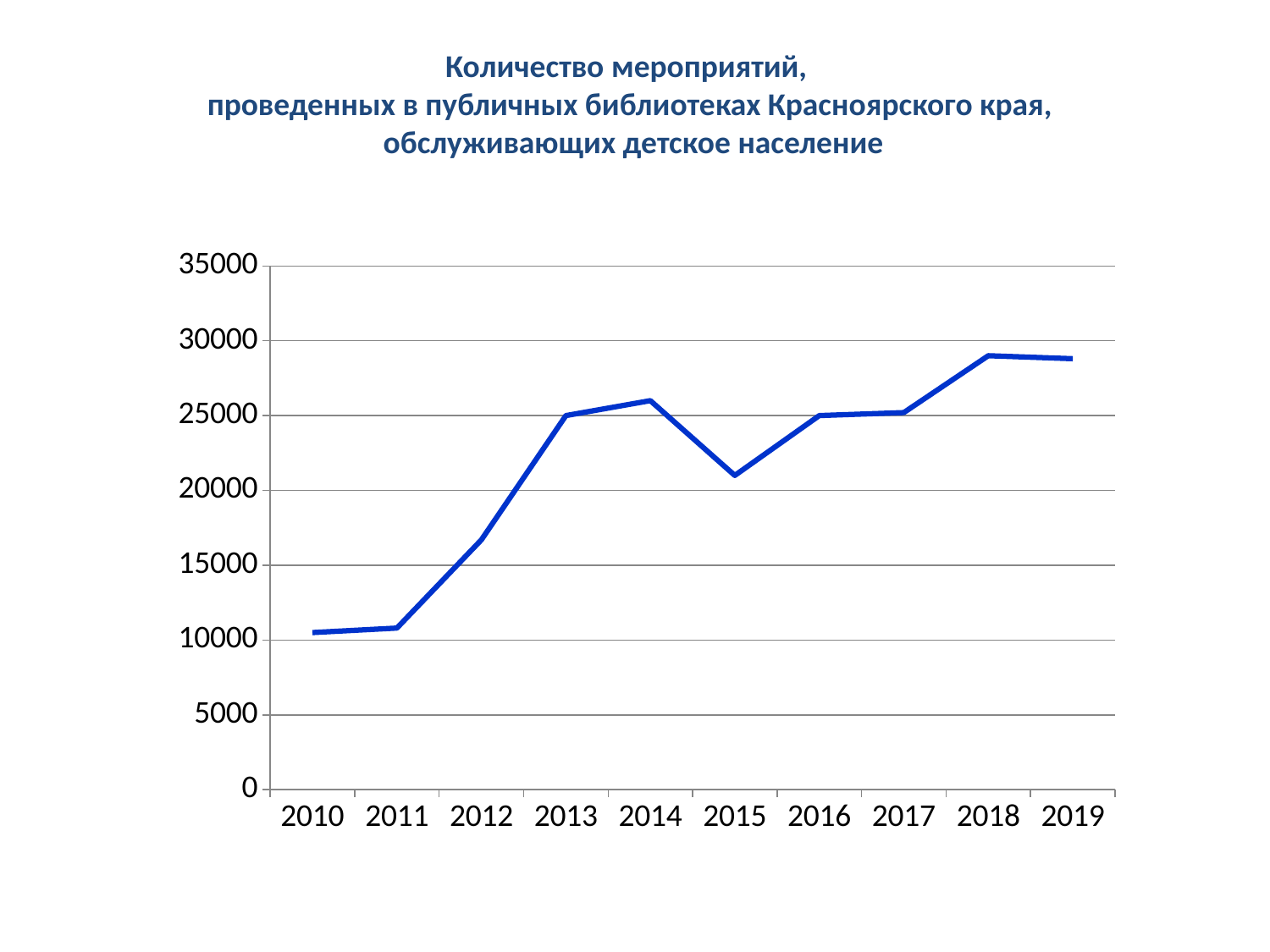
Is the value for 2014 greater or less than 25000? greater Between 2014 and 2015, does the value rise or fall? fall How many years are plotted along the x axis? 10 Is the value for 2013 greater or less than 20000? greater What colour is the plotted line? blue Is the value for 2010 greater or less than 15000? less Which year has the larger value, 2012 or 2016? 2016 What kind of chart is shown on the slide? line chart Does the number of events generally rise or fall from 2010 to 2019? rise Which year has the larger value, 2013 or 2015? 2013